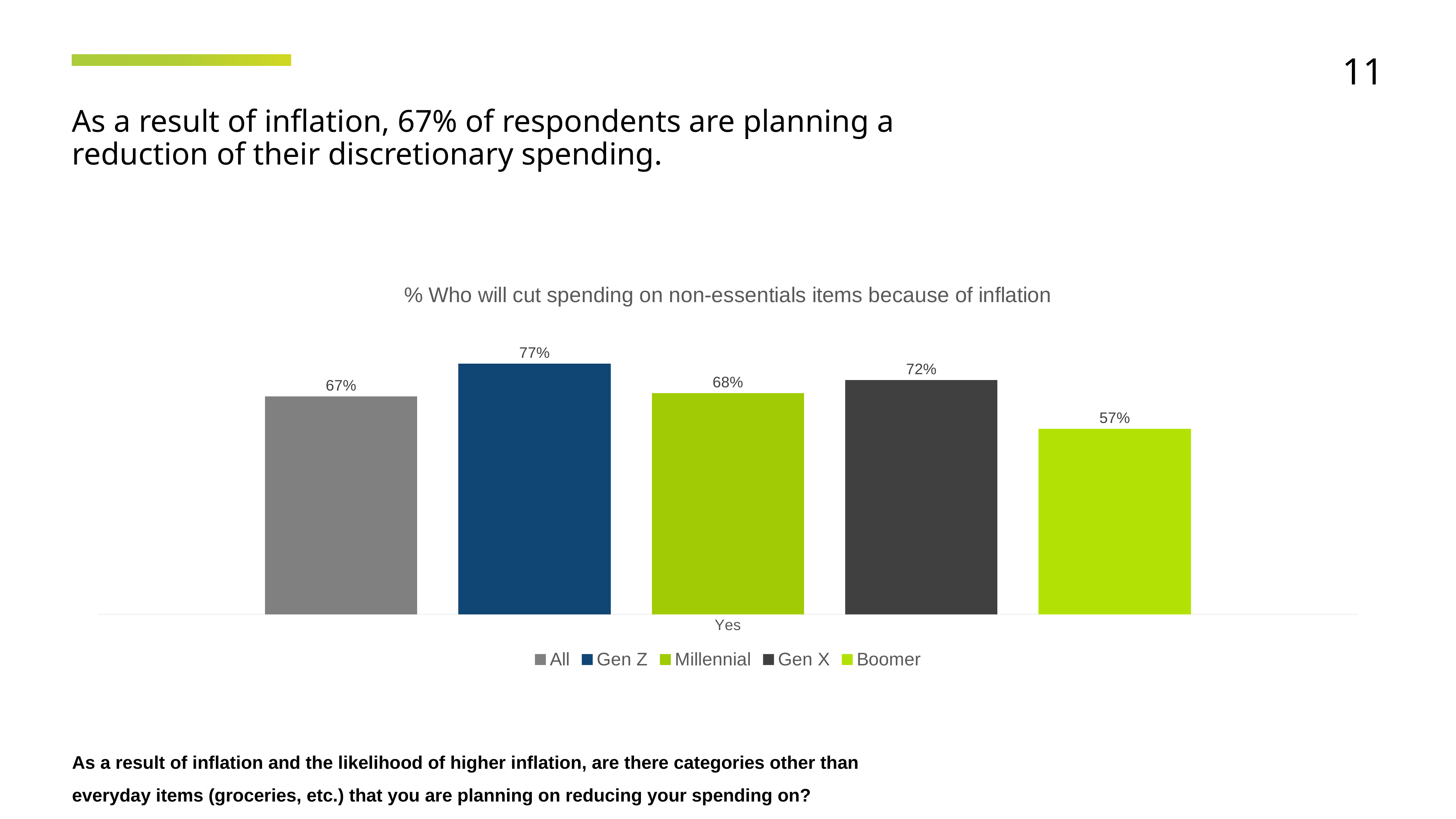
What is the value for Millennial? 68% What is the value for Gen Z? 77% What is the difference between the Gen X value and the All value? 5% Which series has the lowest value? Boomer What is the difference between the Gen Z value and the Boomer value? 20% What is the title of the chart? % Who will cut spending on non-essentials items because of inflation What is the value for Gen X? 72% Which series has the highest value? Gen Z What kind of chart is shown on the slide? Bar chart How many series does the legend list? 5 What is the value for Boomer? 57% Which is larger, the value for Gen X or the value for Millennial? Gen X